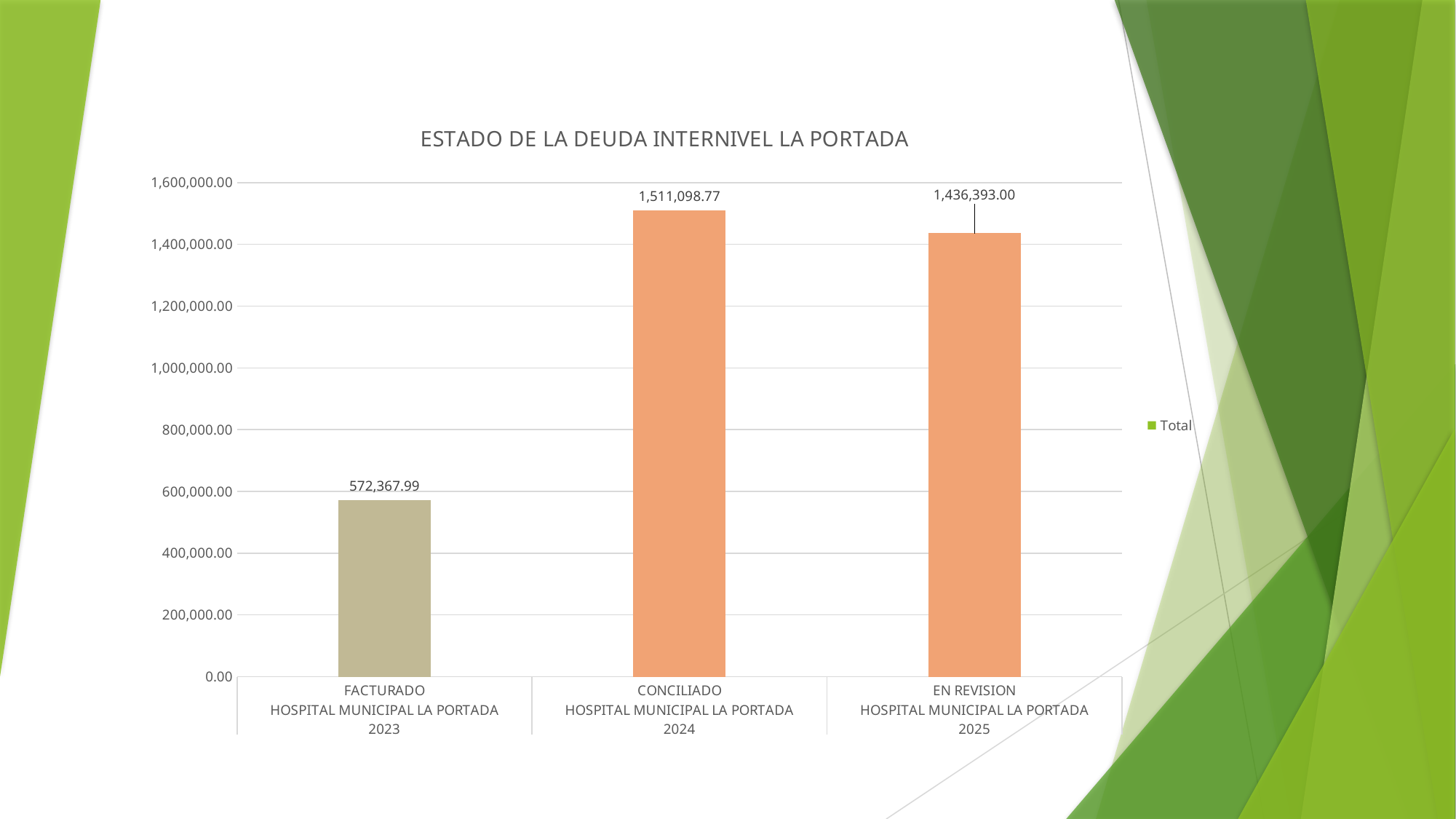
What is the value for FACTURADO (2023)? 572,367.99 What is the title of the chart? ESTADO DE LA DEUDA INTERNIVEL LA PORTADA What is the value for EN REVISION (2025)? 1,436,393.00 What kind of chart is shown on the slide? bar chart What is the difference between the CONCILIADO (2024) value and the EN REVISION (2025) value? 74,705.77 What is the value for CONCILIADO (2024)? 1,511,098.77 Which category has the lowest value? FACTURADO (2023) How many categories are shown on the x axis? 3 Which category has the highest value? CONCILIADO (2024) Is the value for FACTURADO (2023) greater or less than 600,000.00? less What is the difference between the CONCILIADO (2024) value and the FACTURADO (2023) value? 938,730.78 Which is larger, the value for EN REVISION (2025) or the value for FACTURADO (2023)? EN REVISION (2025)